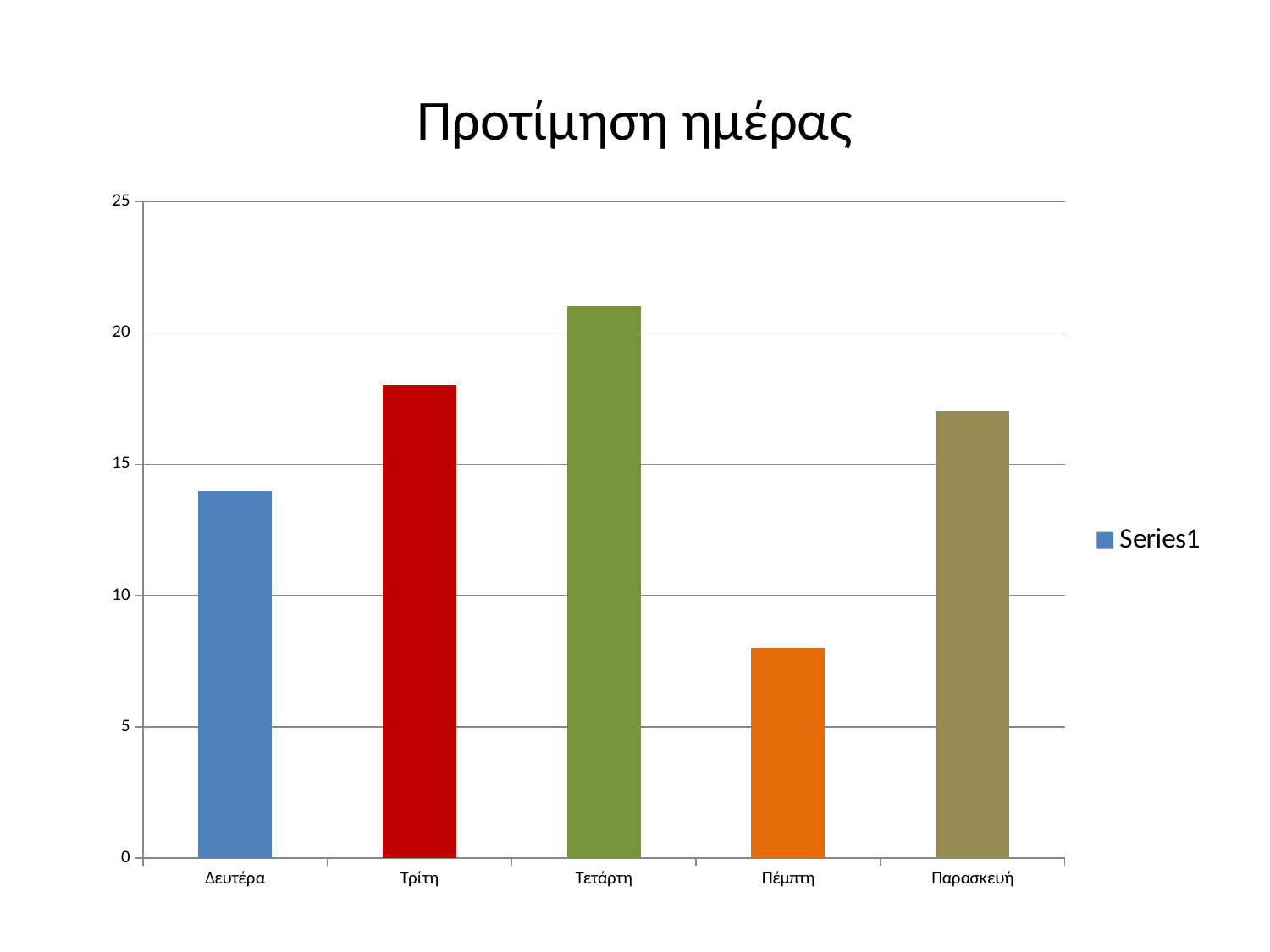
Which is larger, the value for Τρίτη or the value for Δευτέρα? Τρίτη Which is larger, the value for Τετάρτη or the value for Παρασκευή? Τετάρτη Is the value for Πέμπτη greater or less than 10? less What is the title of the chart? Προτίμηση ημέρας What type of chart is shown on the slide? bar chart How many categories are shown on the x axis? 5 Is the value for Δευτέρα greater or less than 15? less Which category has the lowest value? Πέμπτη How many series does the legend list? 1 Which category has the highest value? Τετάρτη Is the value for Τετάρτη greater or less than 20? greater